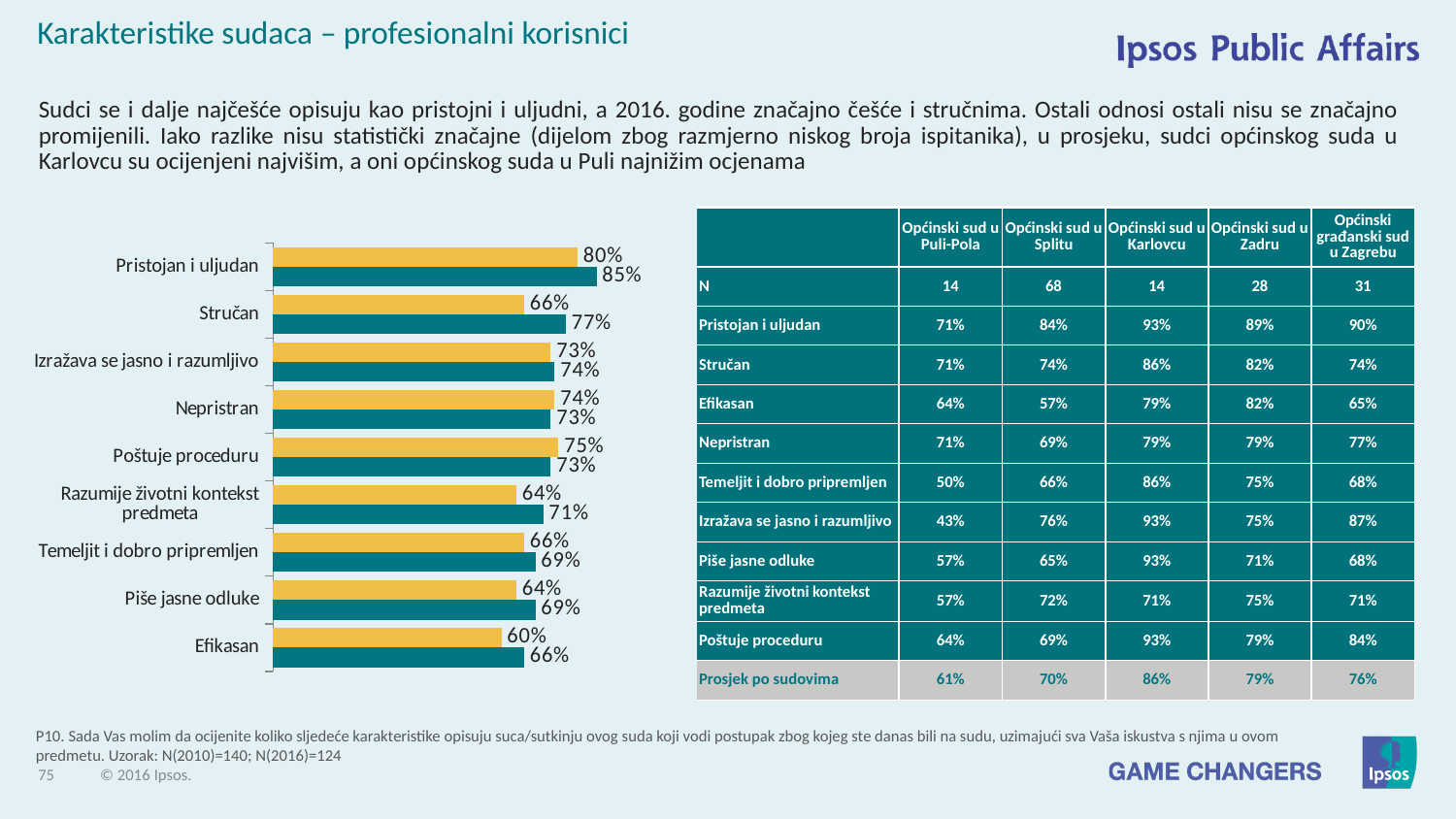
How many categories does the bar chart show? 9 Which category is listed first at the top of the bar chart? Pristojan i uljudan What kind of chart is shown on the slide? bar chart What is the value of the yellow bar for Poštuje proceduru? 75% What is the difference between the teal and yellow bar values for Stručan? 11% What is the value of the yellow bar for Stručan? 66% For Nepristran, which bar is larger, the yellow or the teal? yellow Which category has the lowest yellow bar value? Efikasan Which category has the highest teal bar value? Pristojan i uljudan What is the value of the teal bar for Pristojan i uljudan? 85% What is the value of the teal bar for Efikasan? 66% What is the difference between the teal and yellow bar values for Razumije životni kontekst predmeta? 7%